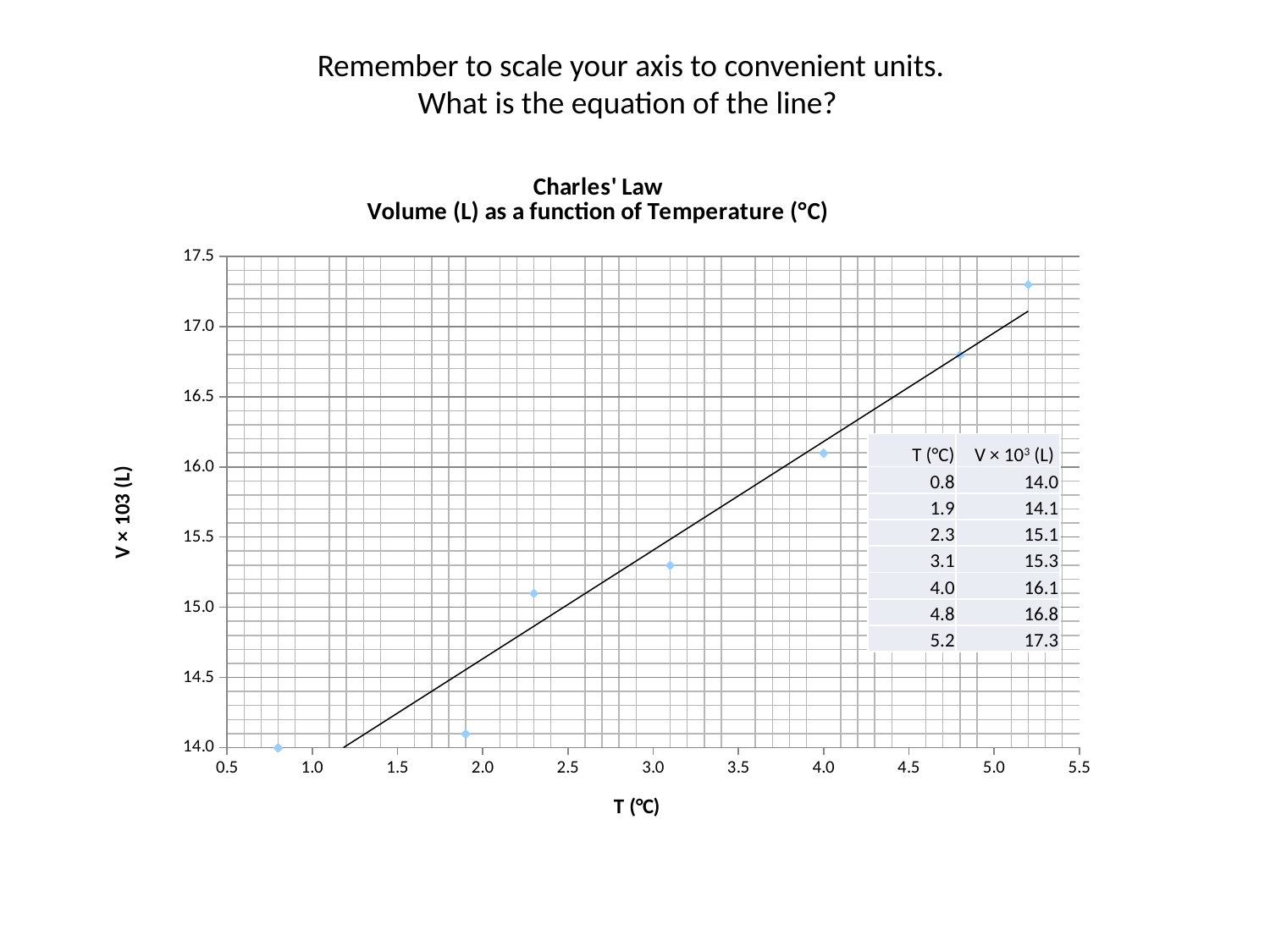
What is the difference between the V × 10³ (L) values at T = 5.2 °C and T = 0.8 °C? 3.3 According to the data table, what is the V × 10³ (L) value at T = 0.8 °C? 14.0 According to the data table, what is the V × 10³ (L) value at T = 4.8 °C? 16.8 Do the plotted volume values rise or fall as temperature increases along the x axis? rise How many data points are plotted on the chart? 7 Is the volume value at T = 4.8 °C greater or less than 16.5? greater Which is larger: the volume value at T = 3.1 °C or at T = 4.0 °C? 4.0 °C What is the title of the chart? Charles' Law Volume (L) as a function of Temperature (°C) At which temperature is the plotted volume value highest? 5.2 What type of chart is shown on the slide? scatter chart At which temperature is the plotted volume value lowest? 0.8 According to the data table, what is the V × 10³ (L) value at T = 2.3 °C? 15.1